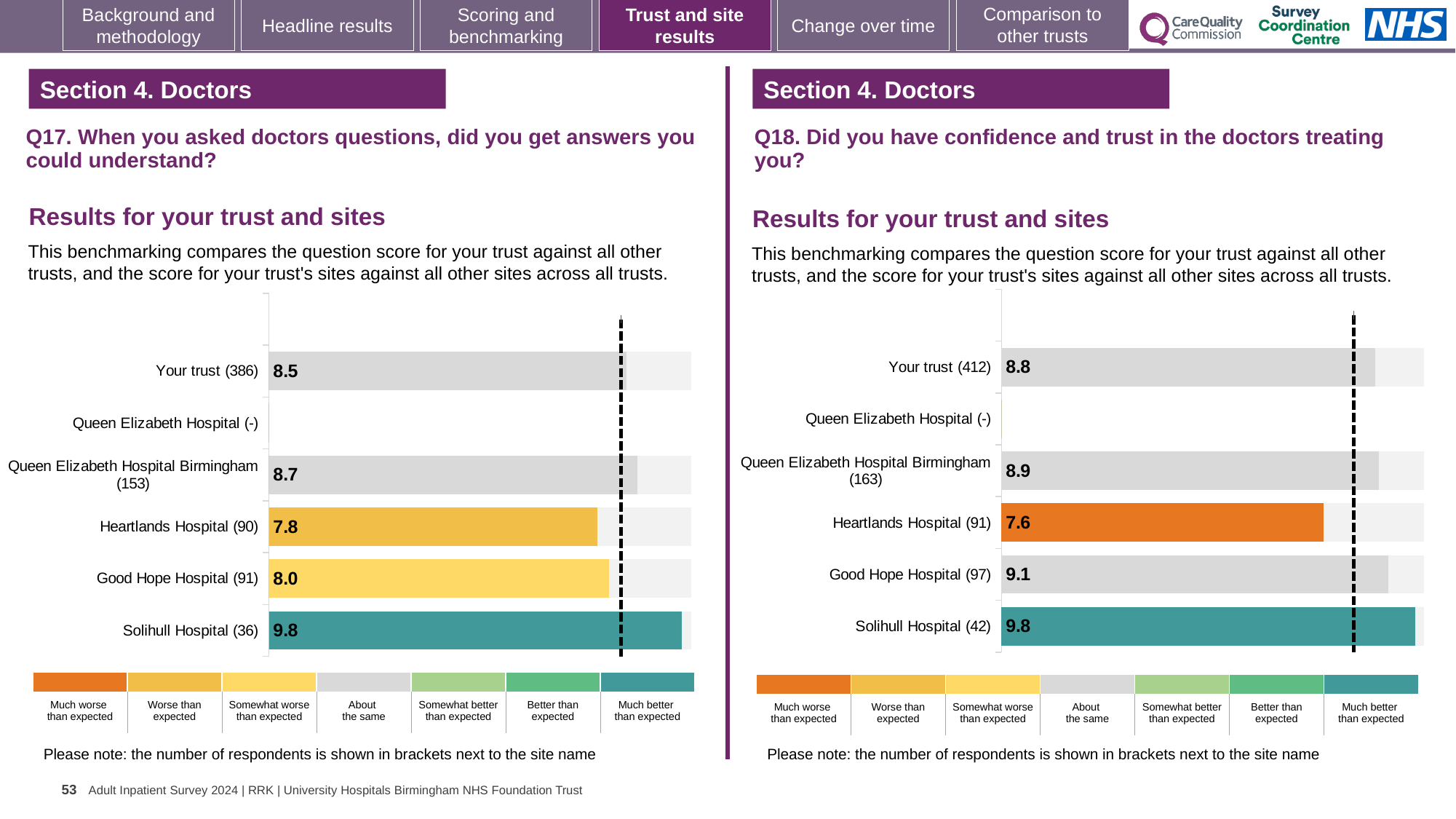
In the Q18 chart on the right, which site has the lowest score? Heartlands Hospital (91) In the Q17 chart on the left, which site has the highest score? Solihull Hospital (36) In the Q17 chart on the left, what is the score for Your trust (386)? 8.5 In the Q18 chart on the right, how many rows have a printed score? 5 In the Q18 chart on the right, which is larger: the score for Your trust (412) or the score for Heartlands Hospital (91)? Your trust (412) In the Q18 chart on the right, what is the difference between the scores for Solihull Hospital (42) and Heartlands Hospital (91)? 2.2 In the Q18 chart on the right, what is the score for Queen Elizabeth Hospital Birmingham (163)? 8.9 In the Q17 chart on the left, what is the difference between the scores for Solihull Hospital (36) and Good Hope Hospital (91)? 1.8 In the Q17 chart on the left, which site has the lowest score? Heartlands Hospital (90) In the Q17 chart on the left, what is the score for Heartlands Hospital (90)? 7.8 What type of chart is used in the Q17 chart on the left? Bar chart In the Q18 chart on the right, what is the score for Good Hope Hospital (97)? 9.1